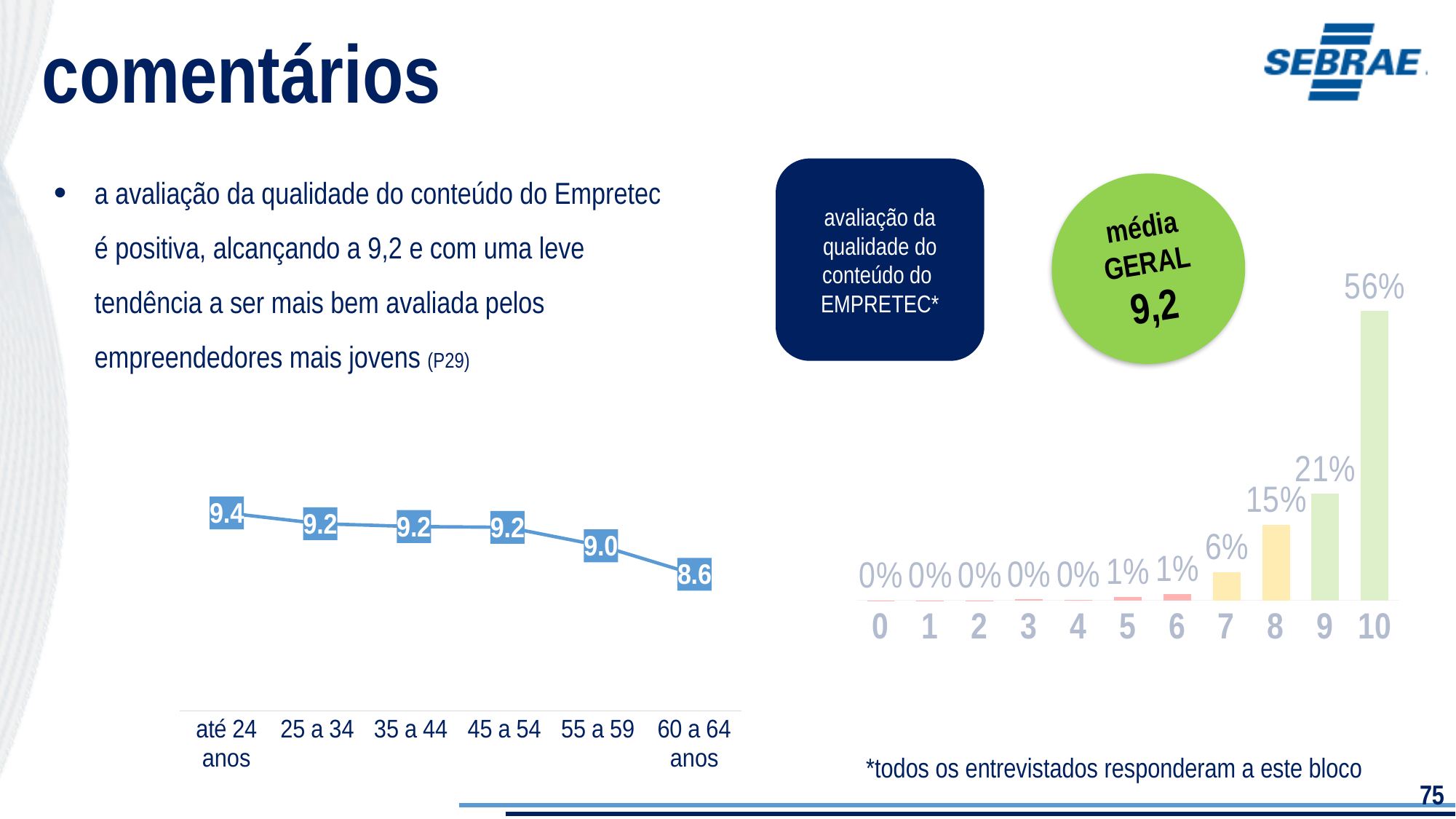
In the line chart on the left, which age group has the highest value? até 24 anos In the bar chart on the right, what percentage of respondents gave a score of 10? 56% In the line chart on the left, what is the difference between the values for 'até 24 anos' and '60 a 64 anos'? 0.8 In the bar chart on the right, what is the difference between the percentages for scores 10 and 9? 35% In the bar chart on the right, which score has the highest percentage? 10 What kind of chart is the chart on the left of the slide? line chart In the line chart on the left, which age group has the lowest value? 60 a 64 anos In the line chart on the left, what is the value for the '60 a 64 anos' age group? 8.6 In the bar chart on the right, what percentage of respondents gave a score of 8? 15% How many age groups are shown in the line chart on the left? 6 In the line chart on the left, do the values rise or fall from the youngest to the oldest age group? fall In the line chart on the left, what is the value for the 'até 24 anos' age group? 9.4